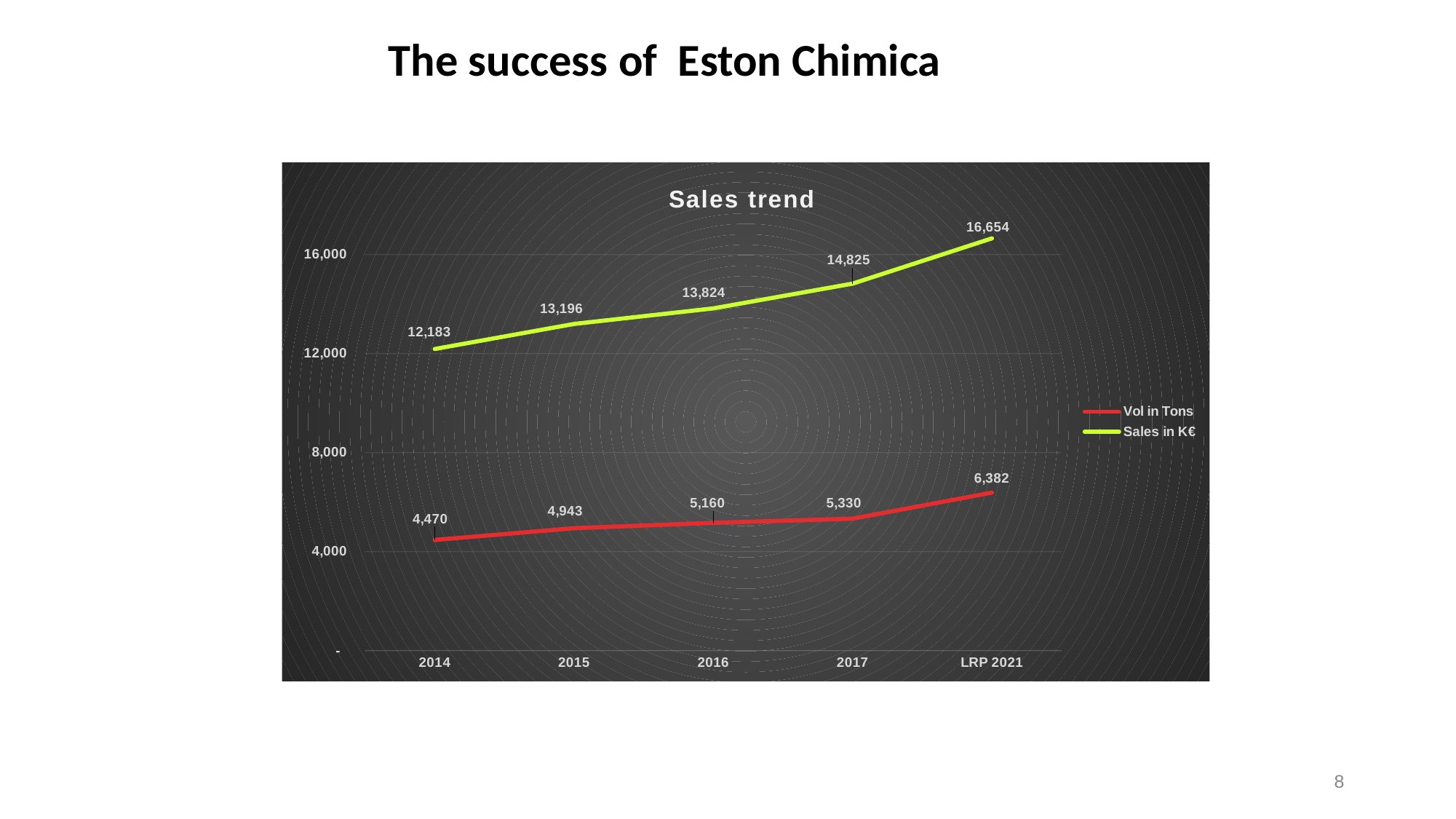
What kind of chart is shown on the slide? Line chart Does Sales in K€ rise or fall from 2014 to LRP 2021? Rise In which period is Sales in K€ highest? LRP 2021 What is the value of Sales in K€ for 2014? 12,183 Which is larger: Sales in K€ in 2016 or Sales in K€ in 2015? 2016 What is the difference between Vol in Tons in 2016 and in 2015? 217 How many series does the legend list? 2 What is the value of Vol in Tons for 2015? 4,943 What is the value of Sales in K€ for LRP 2021? 16,654 In which year is Vol in Tons lowest? 2014 What is the value of Vol in Tons for 2017? 5,330 What is the difference between Sales in K€ in LRP 2021 and in 2017? 1,829